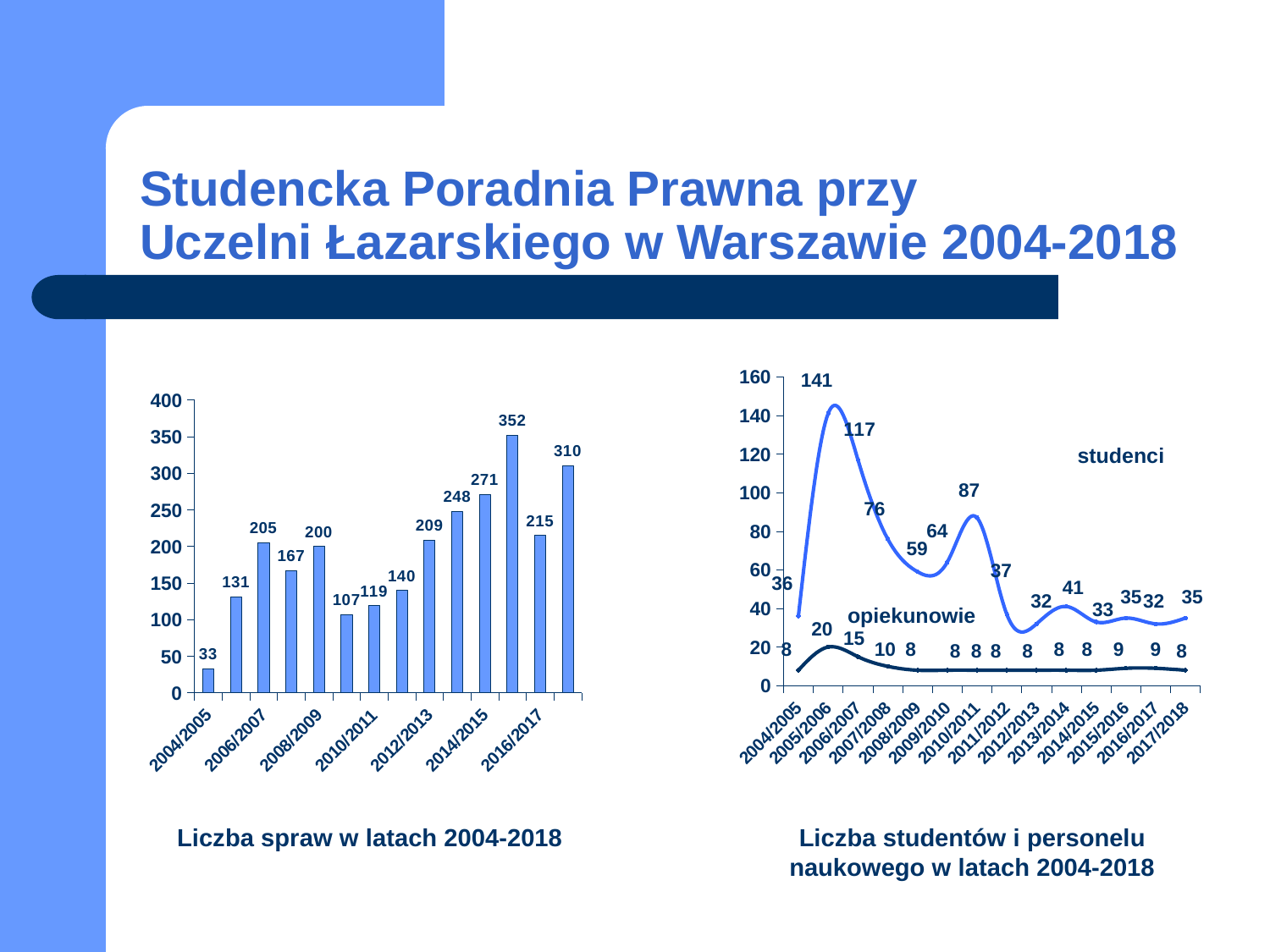
On the left chart (Liczba spraw w latach 2004-2018), what is the difference between the values for 2016/2017 and 2006/2007? 10 On the left chart (Liczba spraw w latach 2004-2018), what is the highest value shown? 352 On the right chart (Liczba studentów i personelu naukowego), what is the value for studenci in 2005/2006? 141 On the left chart (Liczba spraw w latach 2004-2018), what is the value for 2004/2005? 33 On the right chart (Liczba studentów i personelu naukowego), how many series are plotted? 2 On the left chart (Liczba spraw w latach 2004-2018), which year has the lowest value? 2004/2005 On the left chart (Liczba spraw w latach 2004-2018), what is the value for 2014/2015? 271 On the right chart (Liczba studentów i personelu naukowego), what is the value for opiekunowie in 2006/2007? 15 On the left chart (Liczba spraw w latach 2004-2018), which is larger: the value for 2012/2013 or the value for 2010/2011? 2012/2013 On the left chart (Liczba spraw w latach 2004-2018), how many bars are plotted? 14 What type of chart is the left chart (Liczba spraw w latach 2004-2018)? bar chart On the right chart (Liczba studentów i personelu naukowego), what is the difference between studenci and opiekunowie in 2010/2011? 79